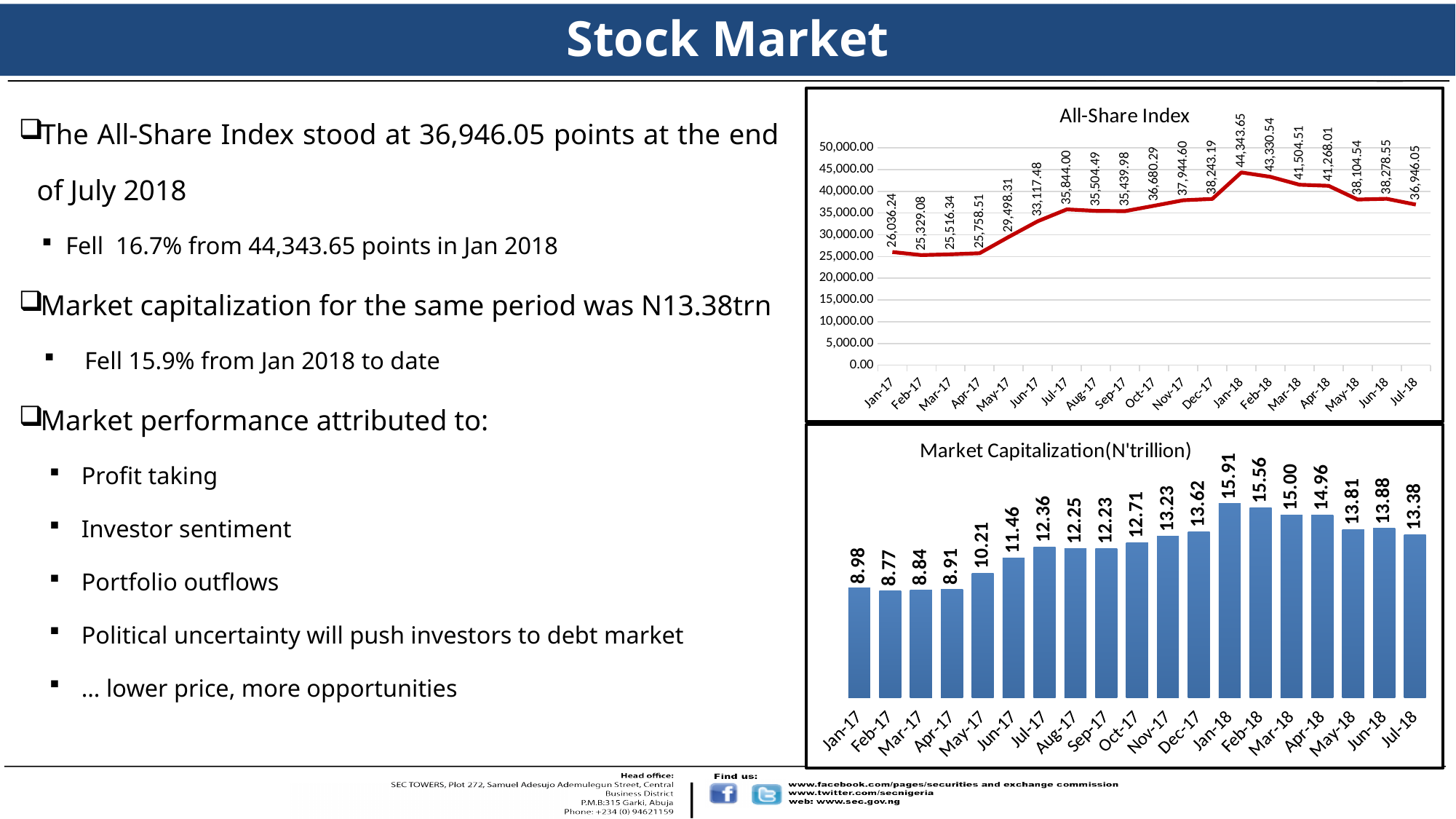
In the Market Capitalization(N'trillion) chart, which month has the lowest value? Feb-17 In the All-Share Index chart, how many data points are plotted? 19 In the Market Capitalization(N'trillion) chart, do the values rise or fall from Jan-17 to Jan-18? Rise In the All-Share Index chart, what is the value for Jul-18? 36,946.05 What type of chart is the All-Share Index chart? Line chart In the Market Capitalization(N'trillion) chart, which is larger, the value for May-18 or the value for Jun-18? Jun-18 In the All-Share Index chart, which month has the highest value? Jan-18 What type of chart is the Market Capitalization(N'trillion) chart? Bar chart In the Market Capitalization(N'trillion) chart, what is the value for Jan-18? 15.91 In the All-Share Index chart, what is the difference between the Jan-18 and Jul-18 values? 7,397.60 In the Market Capitalization(N'trillion) chart, what is the difference between the Jan-18 and Jul-18 values? 2.53 In the All-Share Index chart, which month has the lowest value? Feb-17